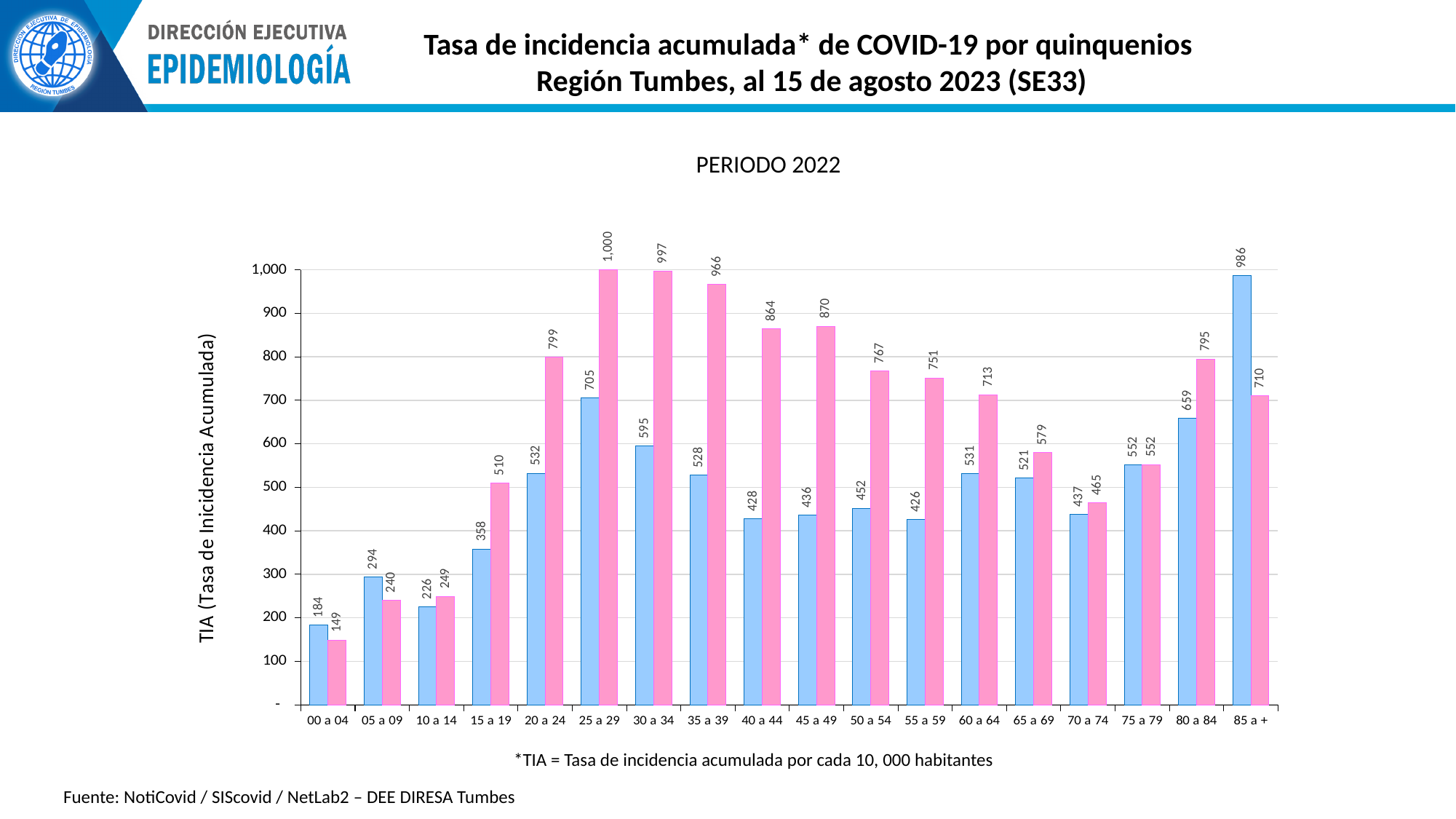
How many age groups are shown on the x axis? 18 What is the title shown above the chart? PERIODO 2022 Which age group has the lowest blue bar? 00 a 04 What is the value of the blue bar for the 75 a 79 age group? 552 What is the y-axis label of the chart? TIA (Tasa de Incidencia Acumulada) Which age group has the highest pink bar? 25 a 29 What is the value of the pink bar for the 40 a 44 age group? 864 What is the difference between the pink and blue bars for the 20 a 24 age group? 267 Which is larger for the 85 a + age group, the blue bar or the pink bar? the blue bar What kind of chart is shown on the slide? bar chart Which age group has the highest blue bar? 85 a + What is the value of the blue bar for the 25 a 29 age group? 705